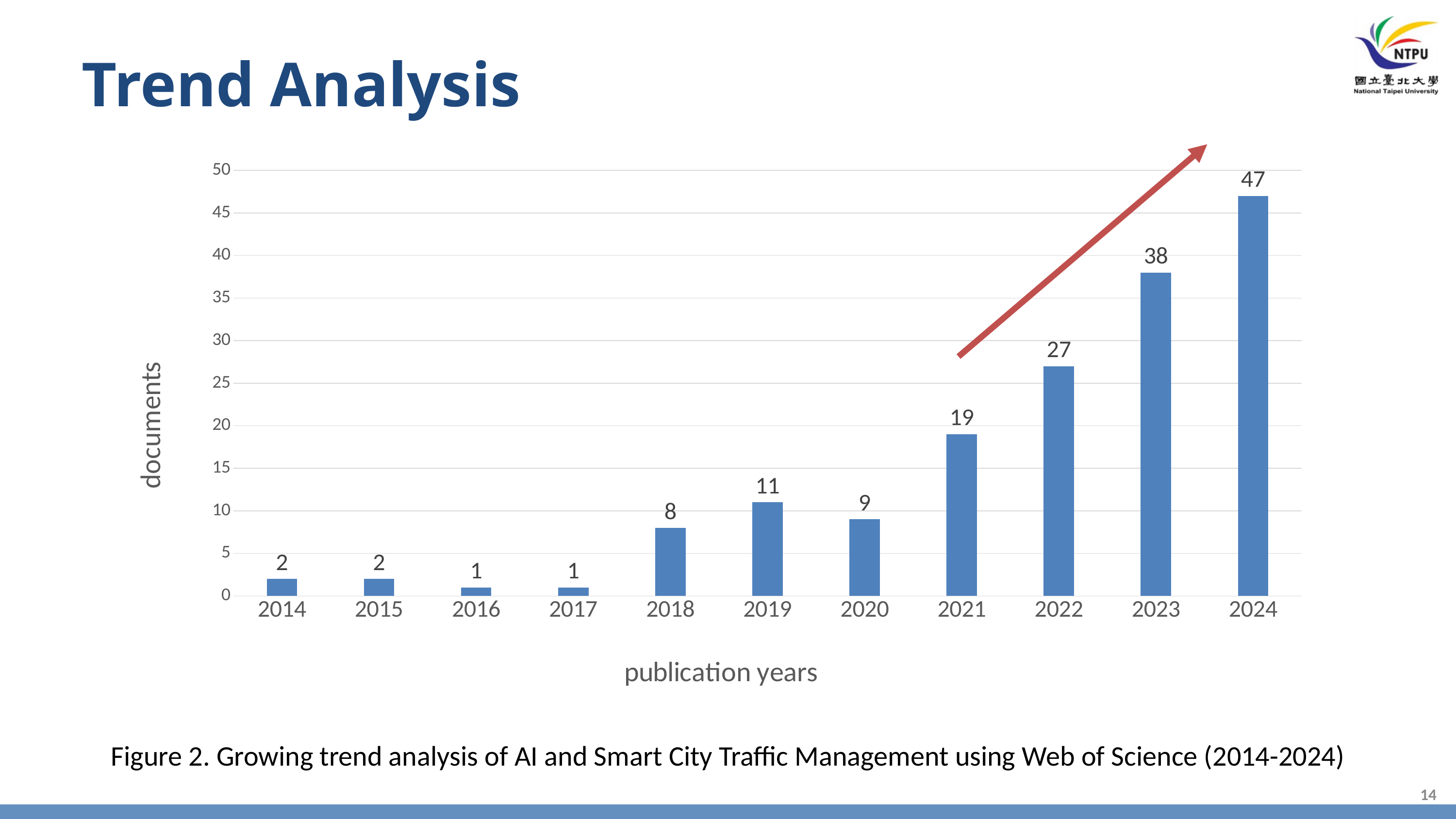
What is the difference in documents between 2024 and 2023? 9 How many publication years are shown on the x axis? 11 Do the document counts generally rise or fall from 2014 to 2024? rise What is the label of the y axis? documents Which year has more documents, 2019 or 2020? 2019 What is the difference in documents between 2022 and 2021? 8 What kind of chart is shown on the slide? bar chart What is the number of documents for 2021? 19 How many documents were published in 2018? 8 How many documents were published in 2024? 47 Which publication year has the highest number of documents? 2024 What is the label of the x axis? publication years